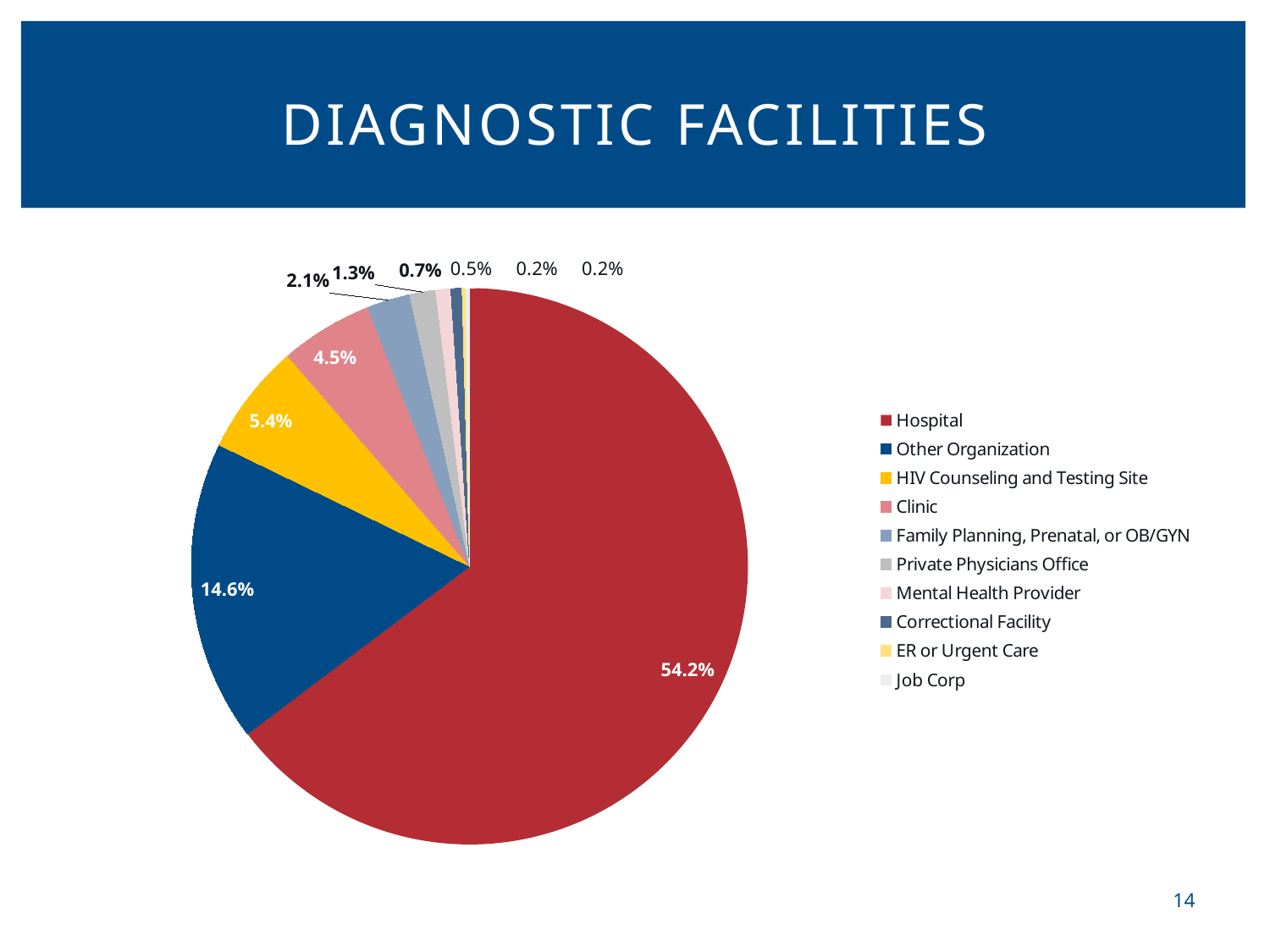
How many categories does the legend list? 10 What type of chart is shown on the slide? Pie chart What is the title of the slide containing the chart? DIAGNOSTIC FACILITIES What is the value for Family Planning, Prenatal, or OB/GYN? 2.1% What is the value for HIV Counseling and Testing Site? 5.4% Which is larger, the share for HIV Counseling and Testing Site or the share for Clinic? HIV Counseling and Testing Site What is the value for Clinic? 4.5% What is the value for Other Organization? 14.6% Which category has the largest slice of the pie? Hospital What is the difference between the Hospital and Other Organization shares? 39.6% What share of the pie does Hospital account for? 54.2% What colour is the Hospital slice in the pie chart? Red